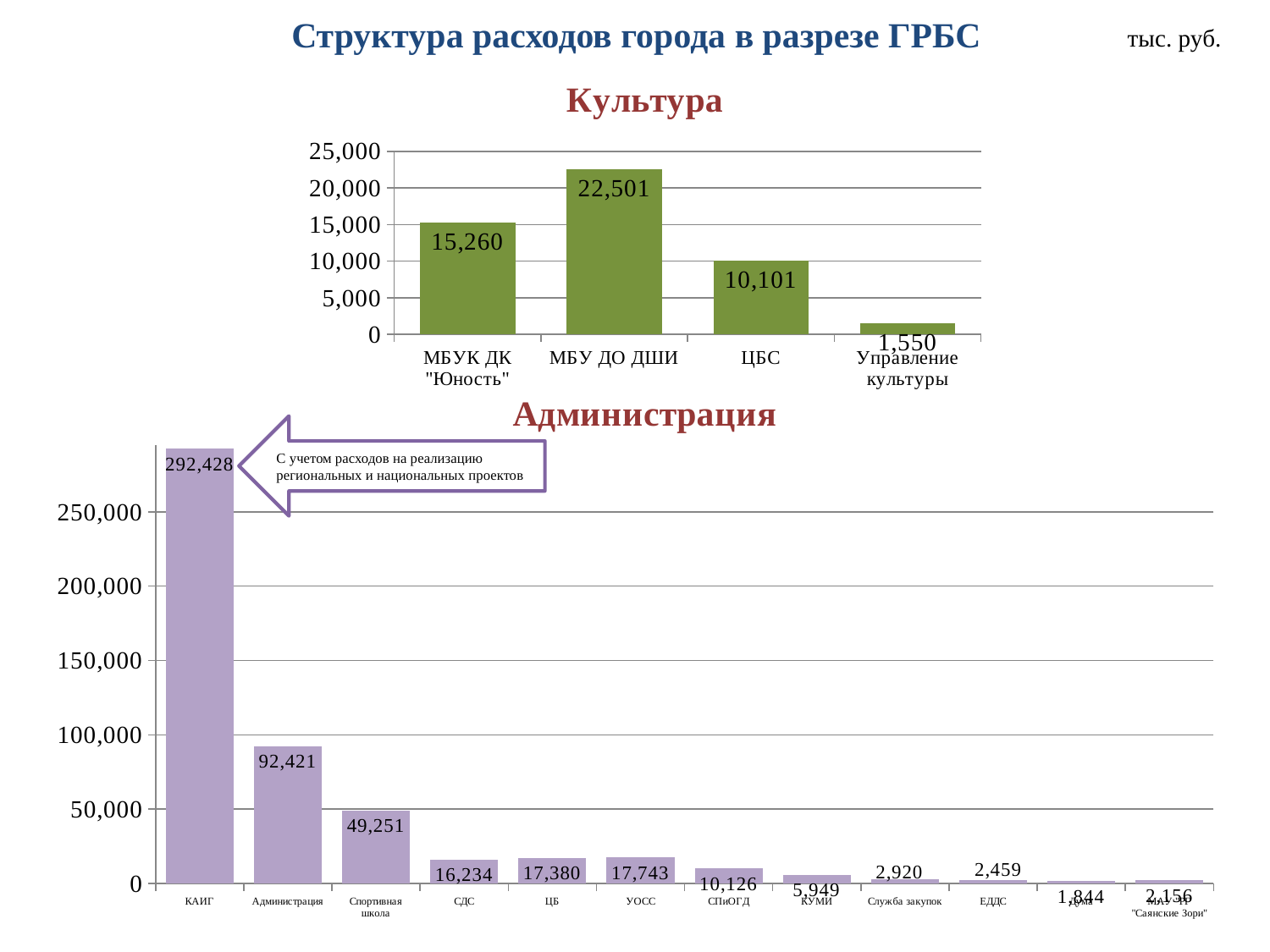
In the Администрация chart, is the value for Администрация greater or less than 100,000? less In the Администрация chart, which is larger: УОСС or ЦБ? УОСС In the Администрация chart, what is the value for Служба закупок? 2,920 In the Культура chart, what is the difference between МБУ ДО ДШИ and ЦБС? 12,400 In the Культура chart, which category has the lowest value? Управление культуры In the Администрация chart, what is the difference between КАИГ and Администрация? 200,007 In the Культура chart, how many categories are shown? 4 What type of chart is the Культура chart? Bar chart In the Культура chart, what is the value for МБУ ДО ДШИ? 22,501 In the Администрация chart, what is the value for Спортивная школа? 49,251 In the Администрация chart, which category has the highest value? КАИГ What unit of measurement is indicated in the top right corner of the slide? тыс. руб.